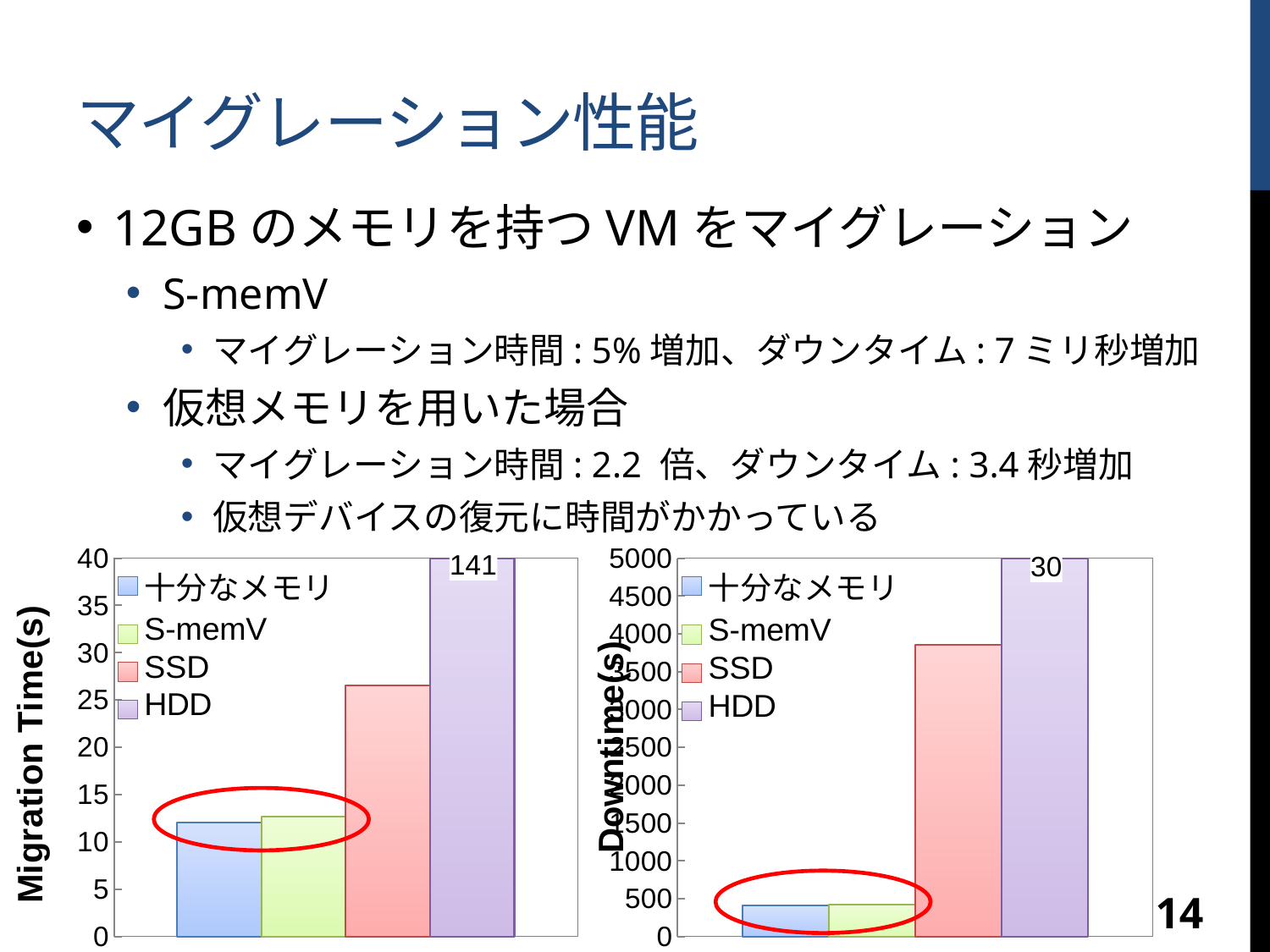
In the left chart (Migration Time(s)), what value is labelled on the HDD bar? 141 In the right chart (Downtime(s)), what value is labelled on the HDD bar? 30 What is the y-axis title of the right chart? Downtime(s) How many series does the legend of the right chart (Downtime(s)) list? 4 In the right chart (Downtime(s)), is the value for SSD greater or less than 3500? greater In the right chart (Downtime(s)), which series has the highest bar? HDD In the left chart (Migration Time(s)), is the value for 十分なメモリ greater or less than 15? less In the left chart (Migration Time(s)), is the value for SSD greater or less than 25? greater In the left chart (Migration Time(s)), which series has the highest bar? HDD What kind of chart is the left chart (Migration Time(s))? bar chart In the left chart (Migration Time(s)), which is larger, the value for SSD or the value for S-memV? SSD